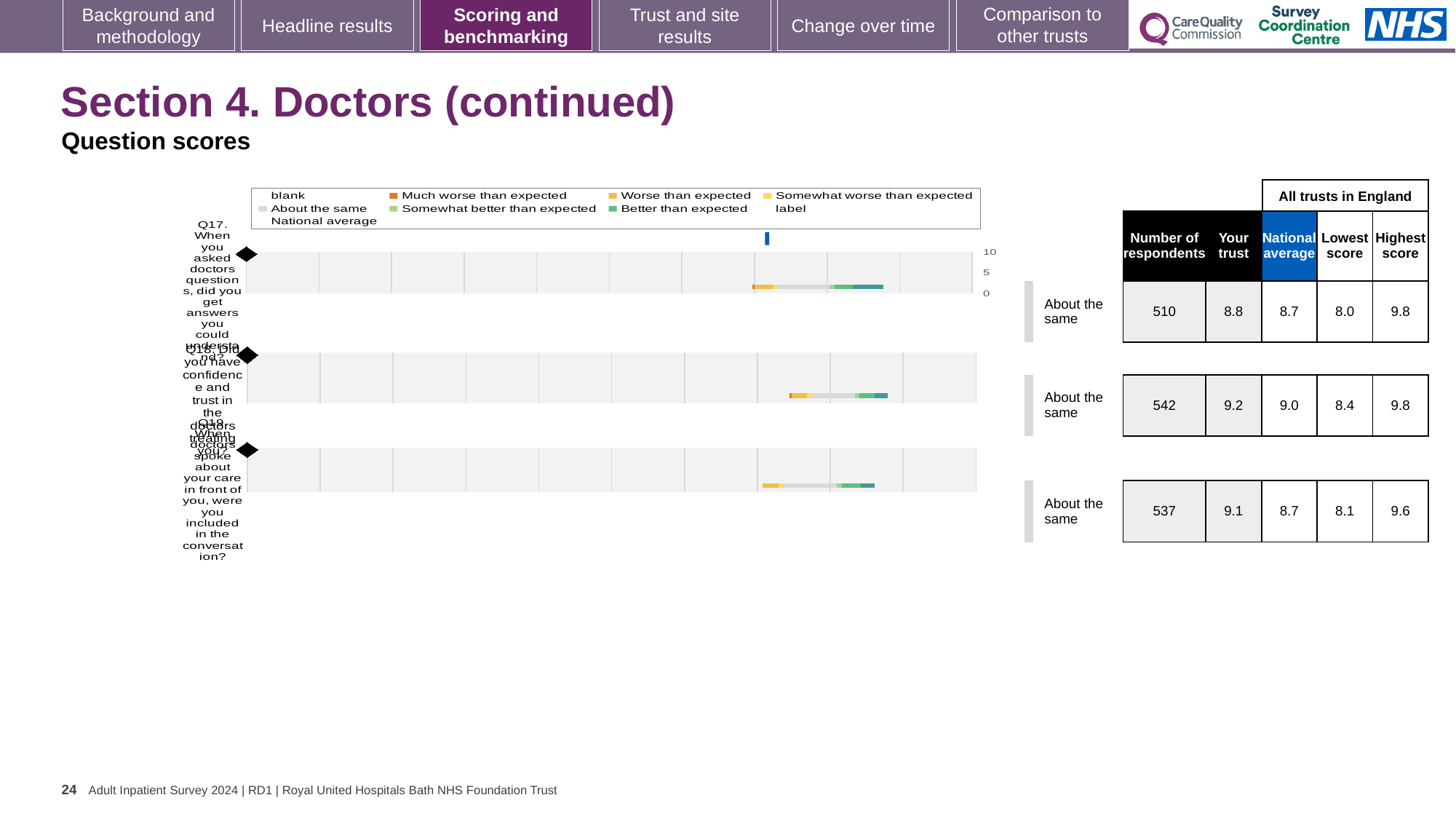
What kind of chart is used to show the question scores for Q17, Q18 and Q19? bar chart What is the national average score for Q19? 8.7 How many questions (Q17, Q18, Q19) are plotted on the slide? 3 What benchmark category is shown next to the Q17 chart? About the same What is the 'Your trust' score for Q18 (confidence and trust in doctors)? 9.2 Which legend entry is shown in orange, immediately after 'blank'? Much worse than expected What is the difference between the 'Your trust' score and the national average for Q19? 0.4 Is the coloured expected-range band for Q17 positioned greater or less than 5 on the axis? greater Is the coloured expected-range band for Q18 positioned greater or less than 5 on the axis? greater How many entries does the chart legend list? 9 What is the highest tick value shown on the chart axis? 10 Which question has the highest 'Your trust' score: Q17, Q18 or Q19? Q18